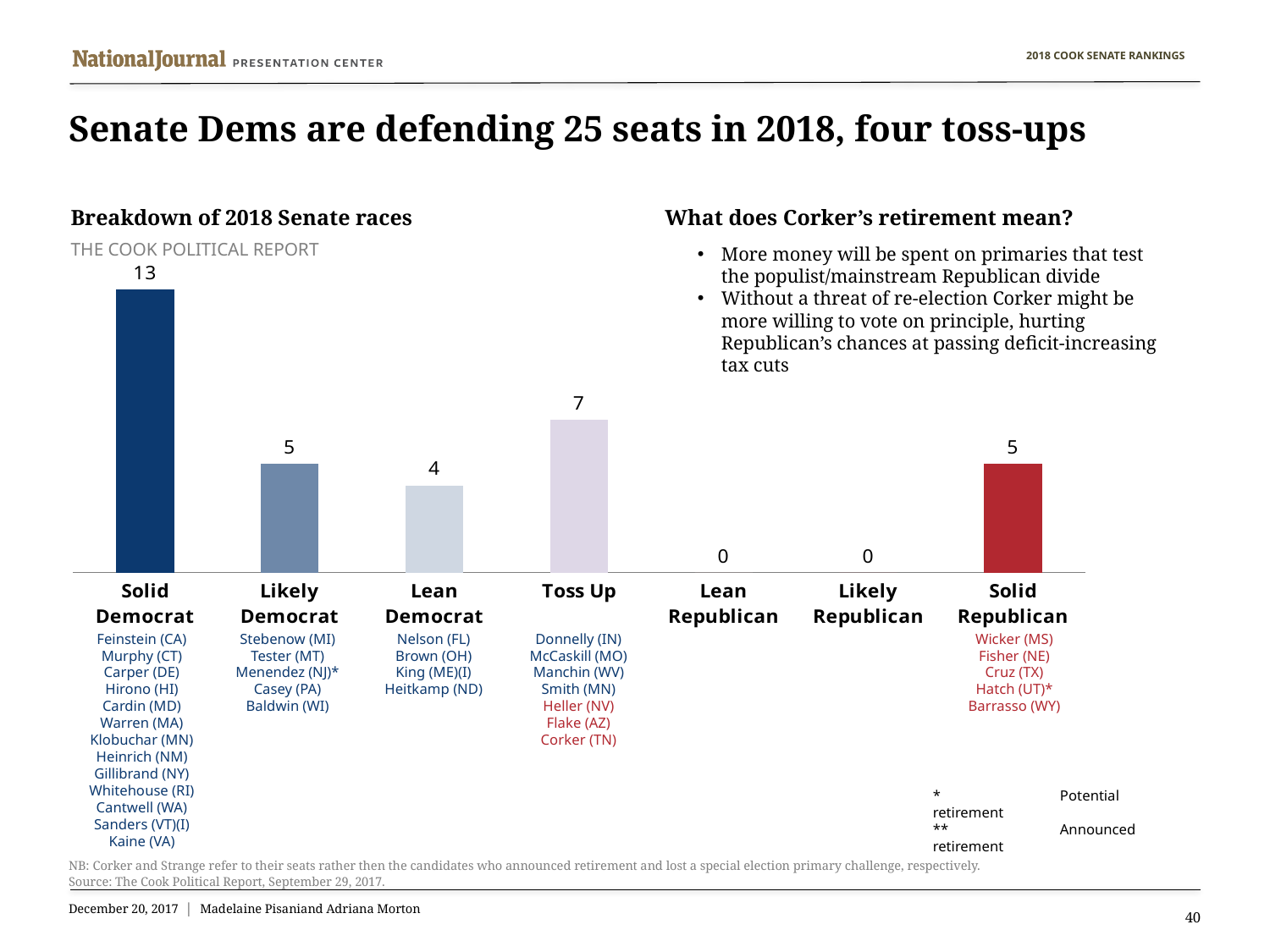
Which is larger, Likely Democrat or Lean Democrat? Likely Democrat What is the value for Lean Democrat? 4 What is the difference between the Toss Up and Likely Democrat values? 2 How many categories are shown on the x axis? 7 What is the total of the Solid Democrat, Likely Democrat and Lean Democrat values? 22 What is the title of the chart? Breakdown of 2018 Senate races What is the value for Solid Democrat? 13 What kind of chart is this? bar chart Which category has the highest value? Solid Democrat What is the difference between the Solid Democrat and Solid Republican values? 8 What is the value for Likely Republican? 0 What is the value for Toss Up? 7